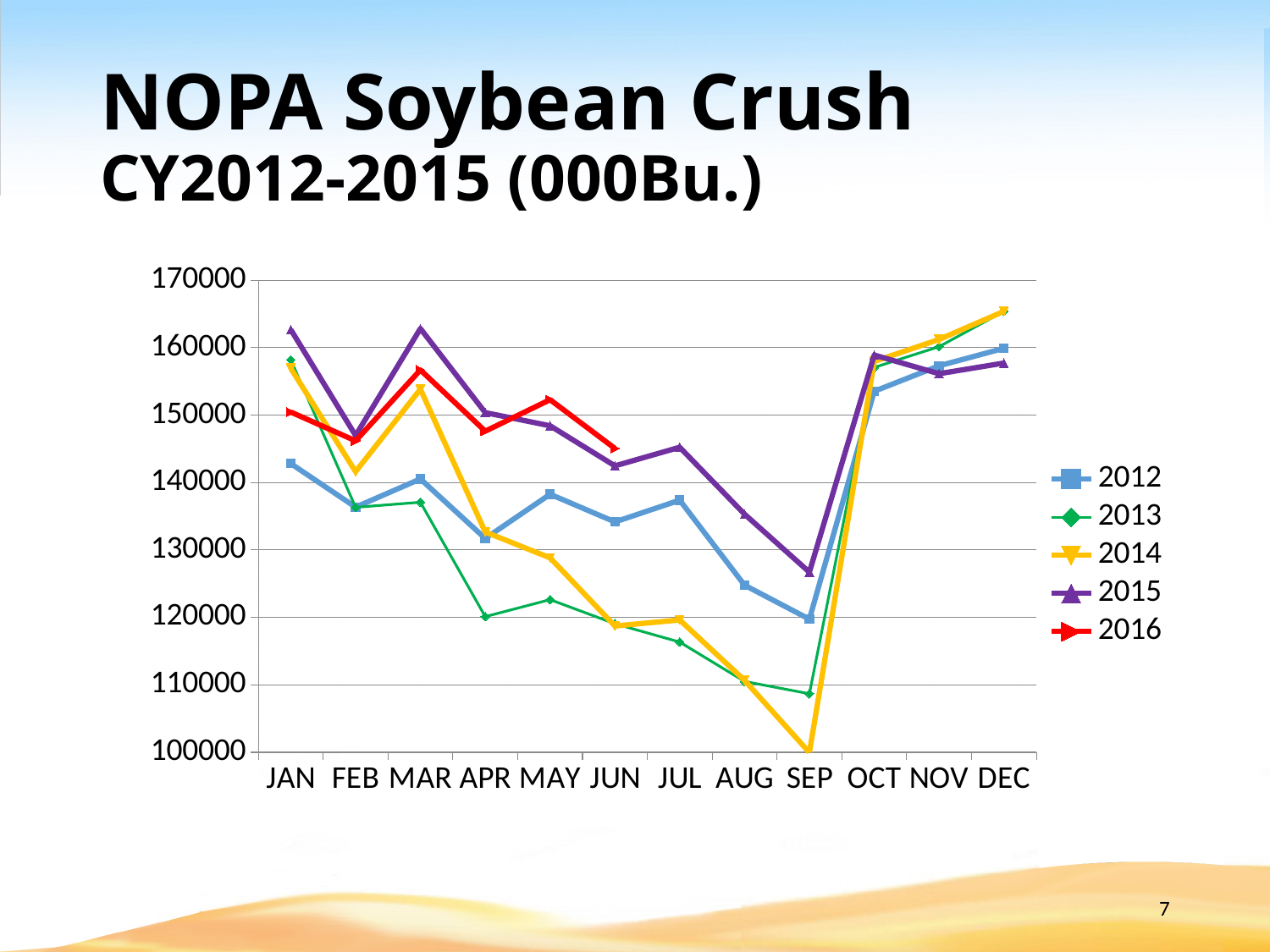
Is the 2012 value for SEP greater or less than 130000? less Is the 2013 value for APR greater or less than 130000? less Is the 2016 value for MAR greater or less than 150000? greater In JUN, which is larger, the 2015 value or the 2012 value? 2015 How many series does the legend list? 5 Which series has the highest value in JAN? 2015 For how many months does the 2016 series have data points? 6 How many months are shown on the x axis? 12 Does the 2014 series rise or fall from JUN to SEP? fall What kind of chart is shown on the slide? line chart In which month is the 2014 series at its lowest? SEP